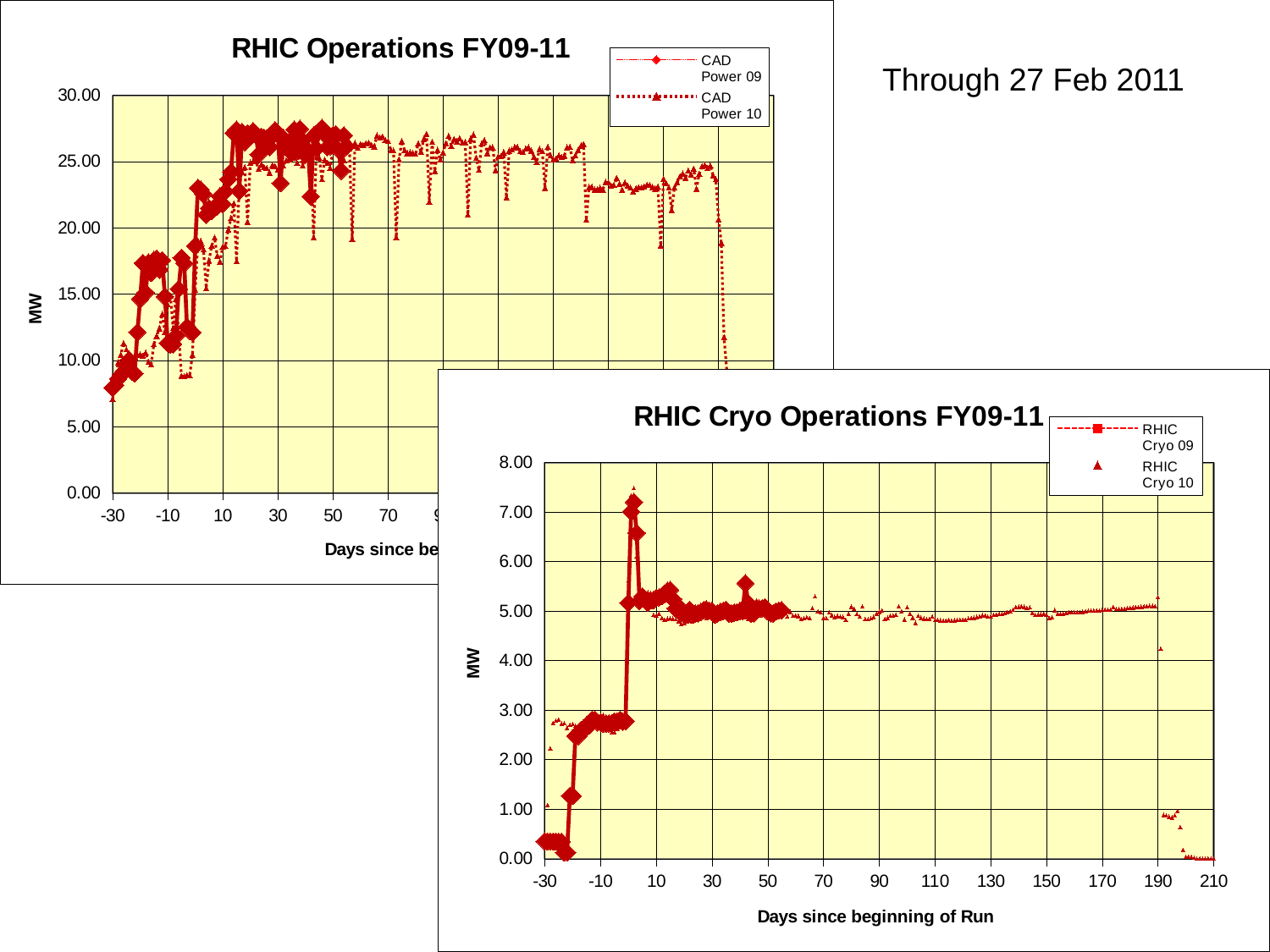
In the "RHIC Cryo Operations FY09-11" chart, does the RHIC Cryo 09 series rise or fall between day -30 and day 10? rise What is the x-axis title of the "RHIC Cryo Operations FY09-11" chart? Days since beginning of Run In the "RHIC Operations FY09-11" chart, does the CAD Power 09 series rise or fall between day -30 and day 10? rise How many series does the legend of the "RHIC Cryo Operations FY09-11" chart list? 2 In the "RHIC Operations FY09-11" chart, is the CAD Power 09 value at day 30 greater or less than 20.00? greater How many series does the legend of the "RHIC Operations FY09-11" chart list? 2 In the "RHIC Cryo Operations FY09-11" chart, is the RHIC Cryo 10 value at day 100 greater or less than 3.00? greater What are the two series named in the legend of the "RHIC Operations FY09-11" chart? CAD Power 09 and CAD Power 10 In the "RHIC Operations FY09-11" chart, is the CAD Power 09 value at day -30 greater or less than 10.00? less What kind of chart is the "RHIC Operations FY09-11" chart? line chart